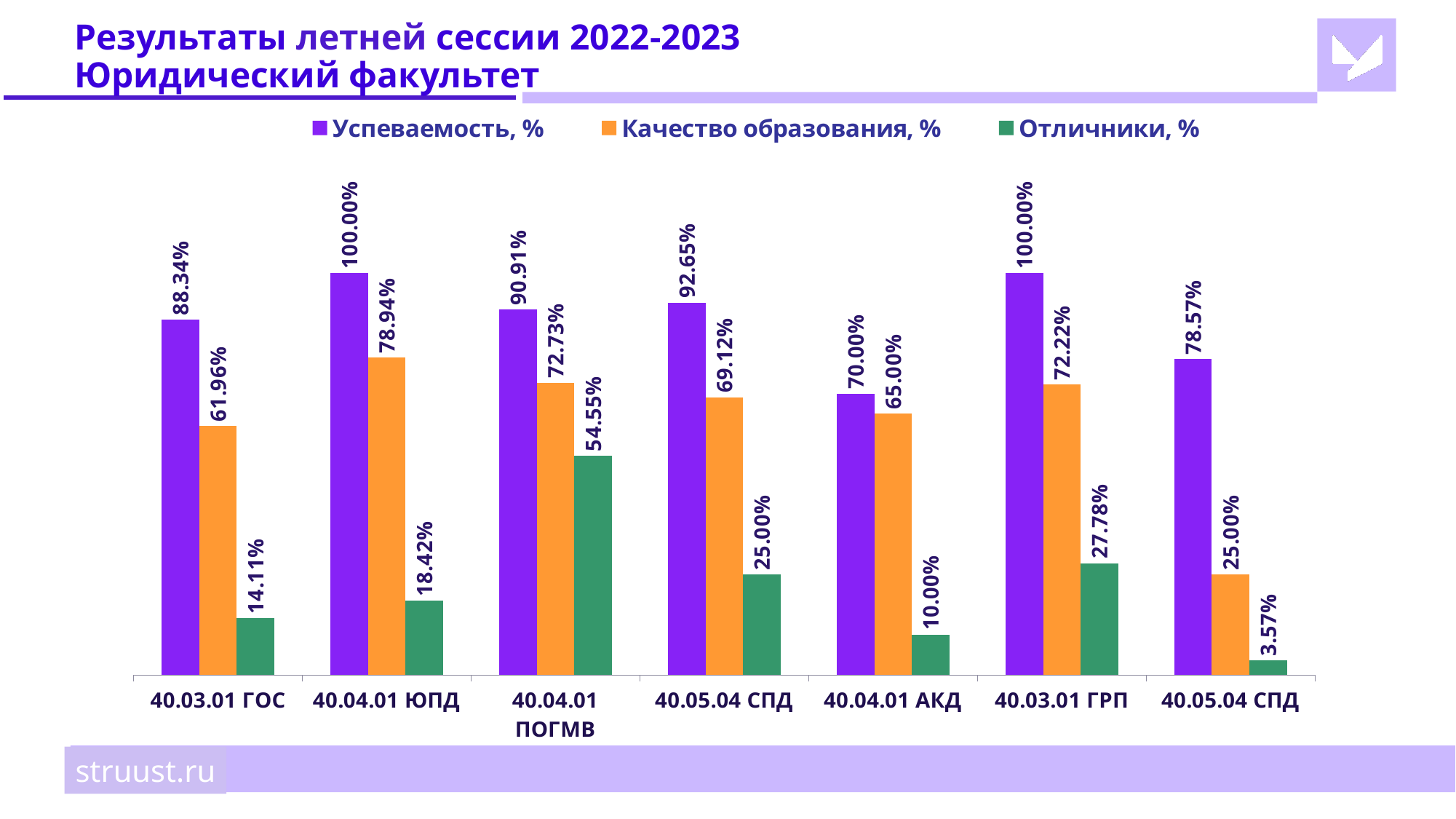
What type of chart is shown on the slide? bar chart What is the value of Успеваемость, % for 40.03.01 ГОС? 88.34% What is the value of Качество образования, % for 40.04.01 ЮПД? 78.94% What is the difference between Успеваемость, % and Качество образования, % for 40.03.01 ГОС? 26.38% Which category has the lowest value of Успеваемость, %? 40.04.01 АКД Which category has the highest value of Отличники, %? 40.04.01 ПОГМВ What is the value of Отличники, % for 40.04.01 ПОГМВ? 54.55% What is the value of Качество образования, % for 40.03.01 ГРП? 72.22% How many series does the legend list? 3 How many categories are shown on the x axis? 7 Which category has the highest value of Качество образования, %? 40.04.01 ЮПД Which is larger for 40.04.01 АКД: Качество образования, % or Отличники, %? Качество образования, %